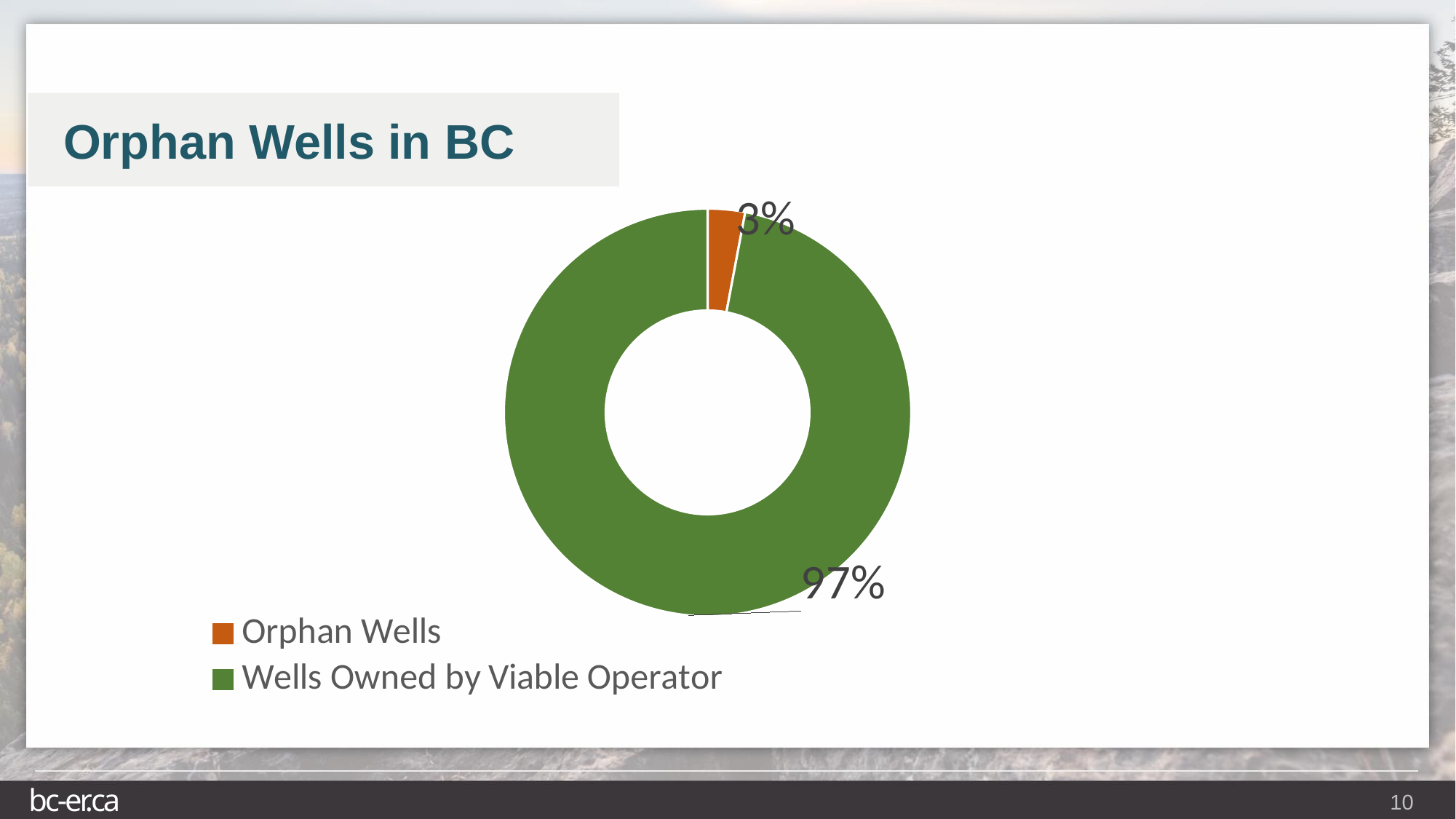
Which is larger, the share for Orphan Wells or the share for Wells Owned by Viable Operator? Wells Owned by Viable Operator What is the difference in percentage points between Wells Owned by Viable Operator and Orphan Wells? 94 What share of the chart does the Orphan Wells slice represent? 3% What percentage of wells are Orphan Wells? 3% Which category has the smallest share of the chart? Orphan Wells How many categories does the chart show? 2 What kind of chart is shown on the slide? Doughnut (pie) chart Which category has the largest share of the chart? Wells Owned by Viable Operator What colour represents Orphan Wells in the chart? Orange What is the title of the slide containing the chart? Orphan Wells in BC What percentage of wells are Wells Owned by Viable Operator? 97%